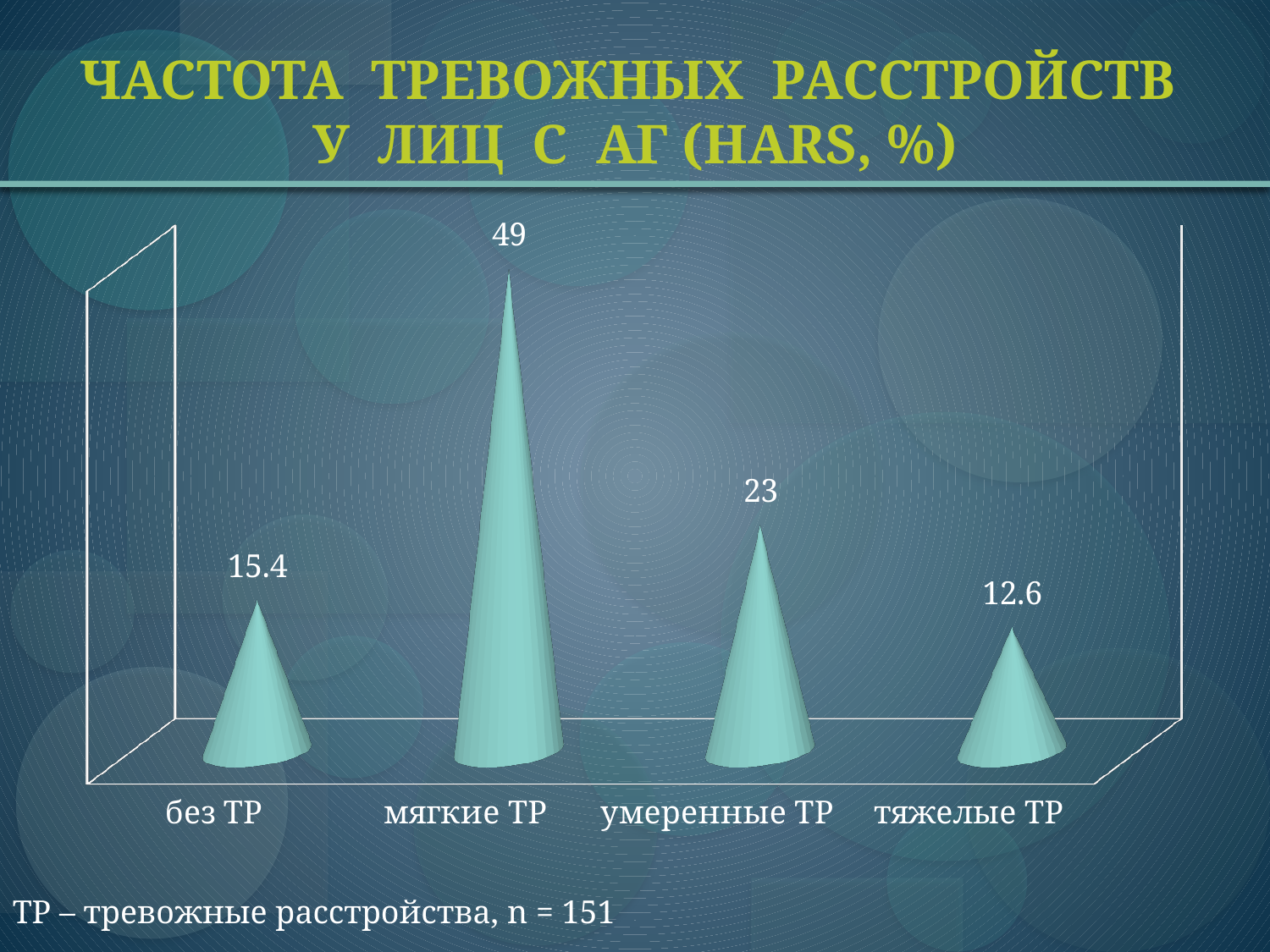
What kind of chart is shown on the slide? bar chart What is the sample size (n) stated in the note below the chart? 151 Which category has the highest value? мягкие ТР What is the value for тяжелые ТР? 12.6 How many categories are shown on the chart? 4 Which category has the lowest value? тяжелые ТР Which is larger, the value for без ТР or the value for умеренные ТР? умеренные ТР What is the difference between the values for мягкие ТР and умеренные ТР? 26 What is the difference between the values for без ТР and тяжелые ТР? 2.8 What is the value for умеренные ТР? 23 What is the value for мягкие ТР? 49 What is the value for без ТР? 15.4